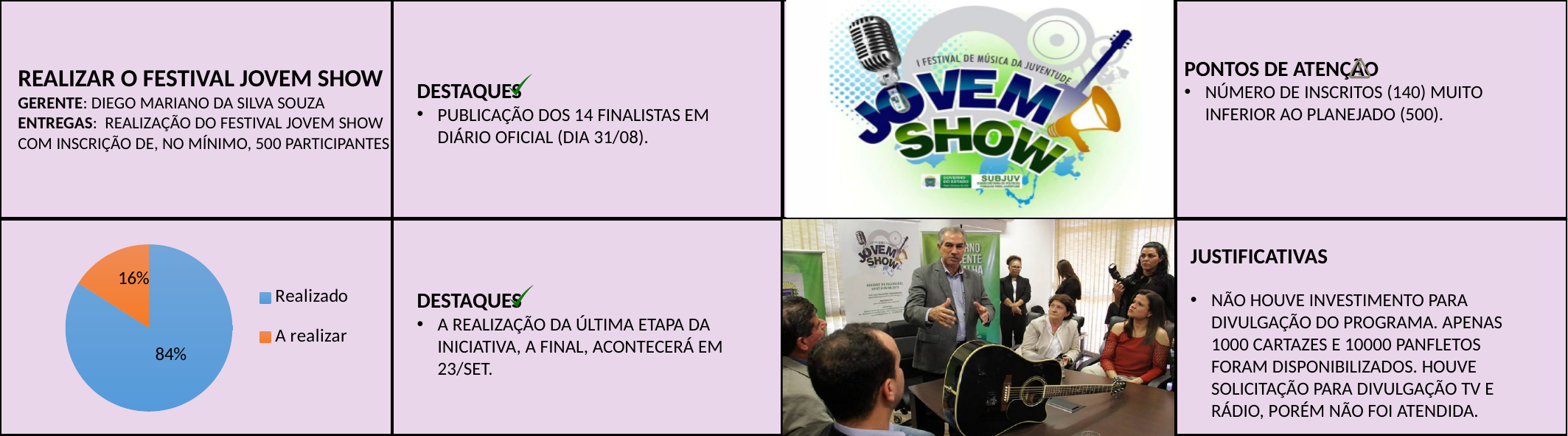
Which slice of the pie chart is the smallest? A realizar What is the difference in percentage points between 'Realizado' and 'A realizar'? 68 How many entries does the legend of the pie chart list? 2 Which is larger, 'Realizado' or 'A realizar'? Realizado What percentage does the 'Realizado' slice represent? 84% What kind of chart is shown on the slide? pie chart What colour is the 'A realizar' slice in the pie chart? orange Which slice of the pie chart is the largest? Realizado How many slices does the pie chart have? 2 What percentage does the 'A realizar' slice represent? 16% What colour is the 'Realizado' slice in the pie chart? blue